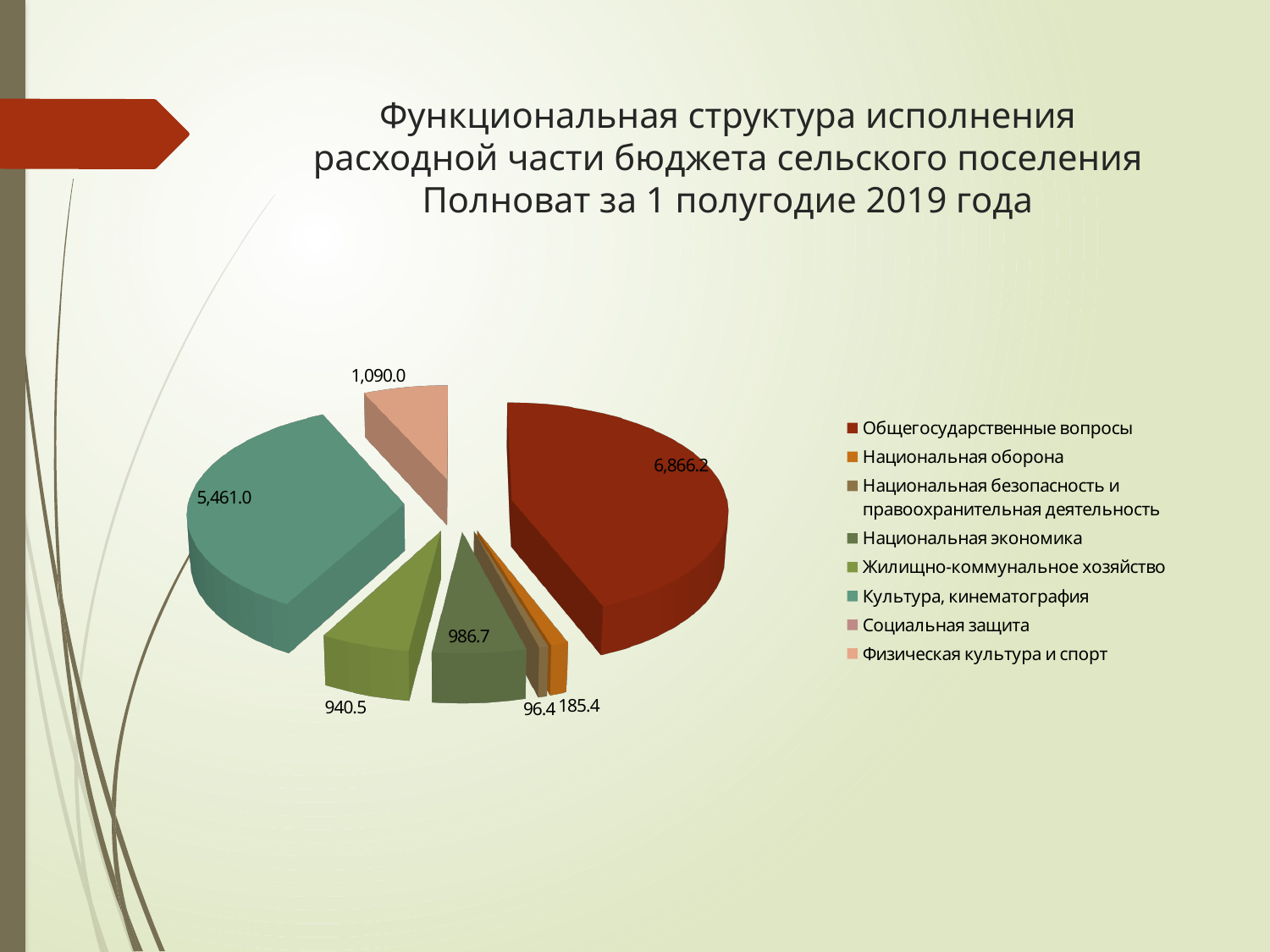
What is the value for Национальная экономика? 986.7 What is the value for Национальная оборона? 185.4 Which category has the largest slice of the pie? Общегосударственные вопросы Which is larger, Общегосударственные вопросы or Культура, кинематография? Общегосударственные вопросы What type of chart is shown on the slide? Pie chart What is the value for Общегосударственные вопросы? 6,866.2 What is the difference between the values for Общегосударственные вопросы and Культура, кинематография? 1,405.2 What colour is the slice for Общегосударственные вопросы? Dark red What is the value for Жилищно-коммунальное хозяйство? 940.5 What is the difference between the values for Национальная экономика and Жилищно-коммунальное хозяйство? 46.2 How many categories does the legend list? 8 What is the value for Культура, кинематография? 5,461.0